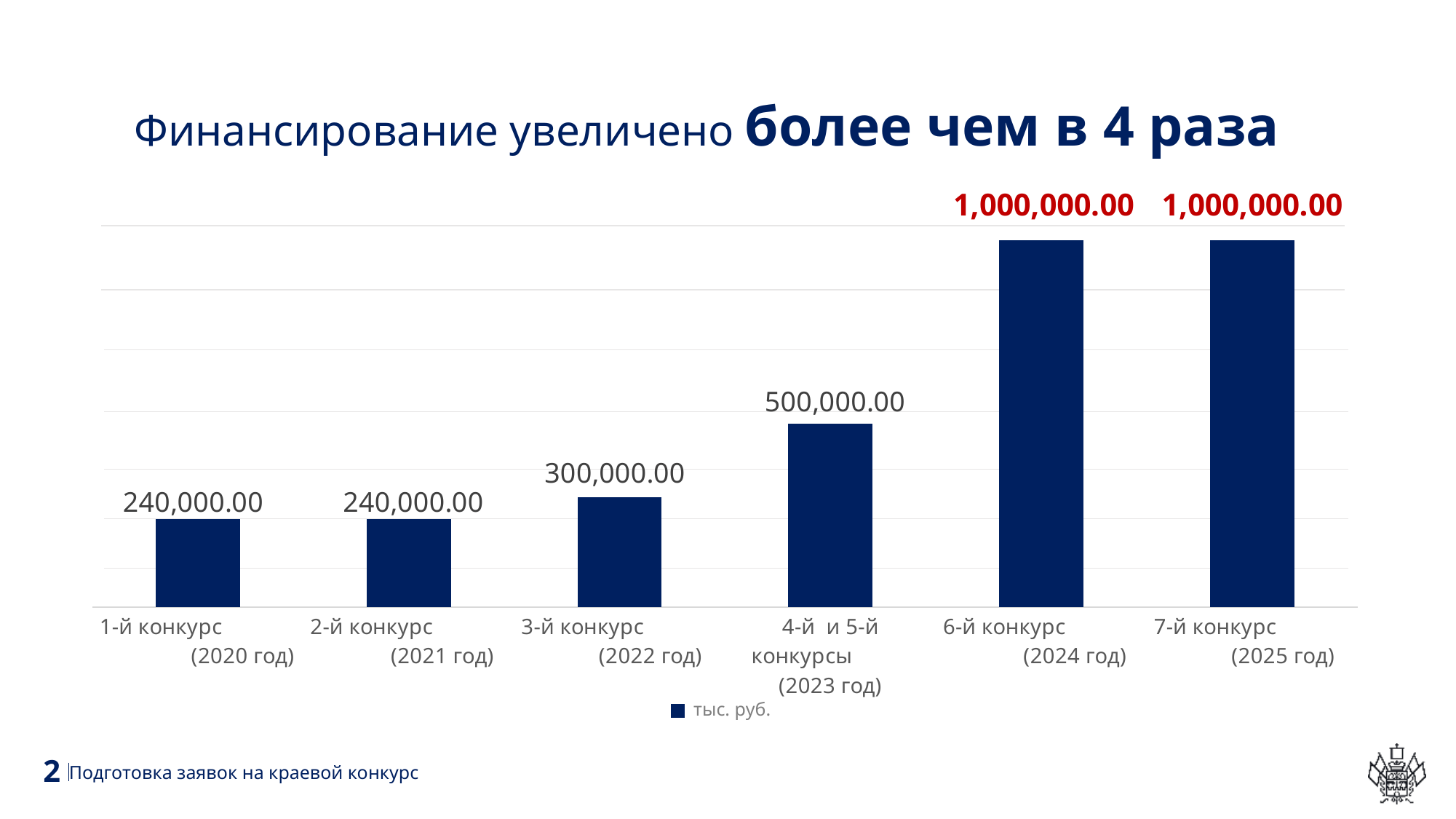
How many series does the legend list? 1 Which is larger: the value for 3-й конкурс (2022 год) or 4-й и 5-й конкурсы (2023 год)? 4-й и 5-й конкурсы (2023 год) What is the value for 7-й конкурс (2025 год)? 1,000,000.00 What kind of chart is shown on the slide? Bar chart What is the value for 1-й конкурс (2020 год)? 240,000.00 How many categories are shown on the x axis? 6 What is the difference between the values for 3-й конкурс (2022 год) and 2-й конкурс (2021 год)? 60,000.00 What is the difference between the values for 6-й конкурс (2024 год) and 4-й и 5-й конкурсы (2023 год)? 500,000.00 What is the legend entry for the series? тыс. руб. What is the value for 3-й конкурс (2022 год)? 300,000.00 What is the value for 4-й и 5-й конкурсы (2023 год)? 500,000.00 Which category has the lowest value? 1-й конкурс (2020 год) and 2-й конкурс (2021 год), both 240,000.00